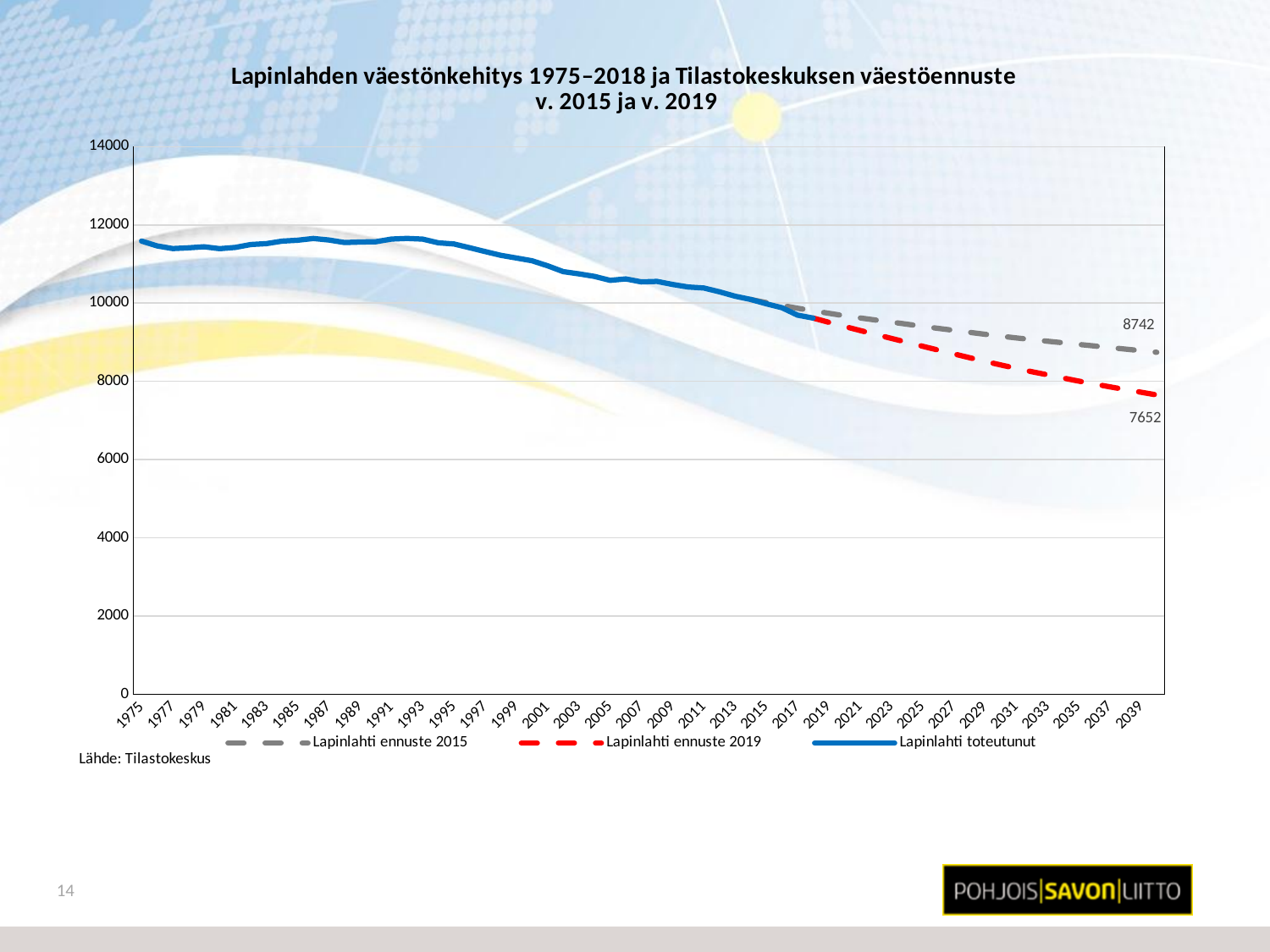
What kind of chart is shown on the slide? line chart What is the final labelled value of the Lapinlahti ennuste 2015 series? 8742 What is the final labelled value of the Lapinlahti ennuste 2019 series? 7652 Is the value of Lapinlahti toteutunut in 1975 greater or less than 10000? greater Does the Lapinlahti toteutunut series rise or fall overall from 1975 to its end? fall What colour is the Lapinlahti toteutunut line? blue Which forecast series ends at a higher value, Lapinlahti ennuste 2015 or Lapinlahti ennuste 2019? Lapinlahti ennuste 2015 What is the title of the chart? Lapinlahden väestönkehitys 1975–2018 ja Tilastokeskuksen väestöennuste v. 2015 ja v. 2019 Is the value of Lapinlahti ennuste 2015 in 2031 greater or less than 8000? greater Is the value of Lapinlahti toteutunut in 1985 greater or less than 12000? less What is the difference between the final labelled values of the 2015 forecast (8742) and the 2019 forecast (7652)? 1090 How many series does the legend list? 3